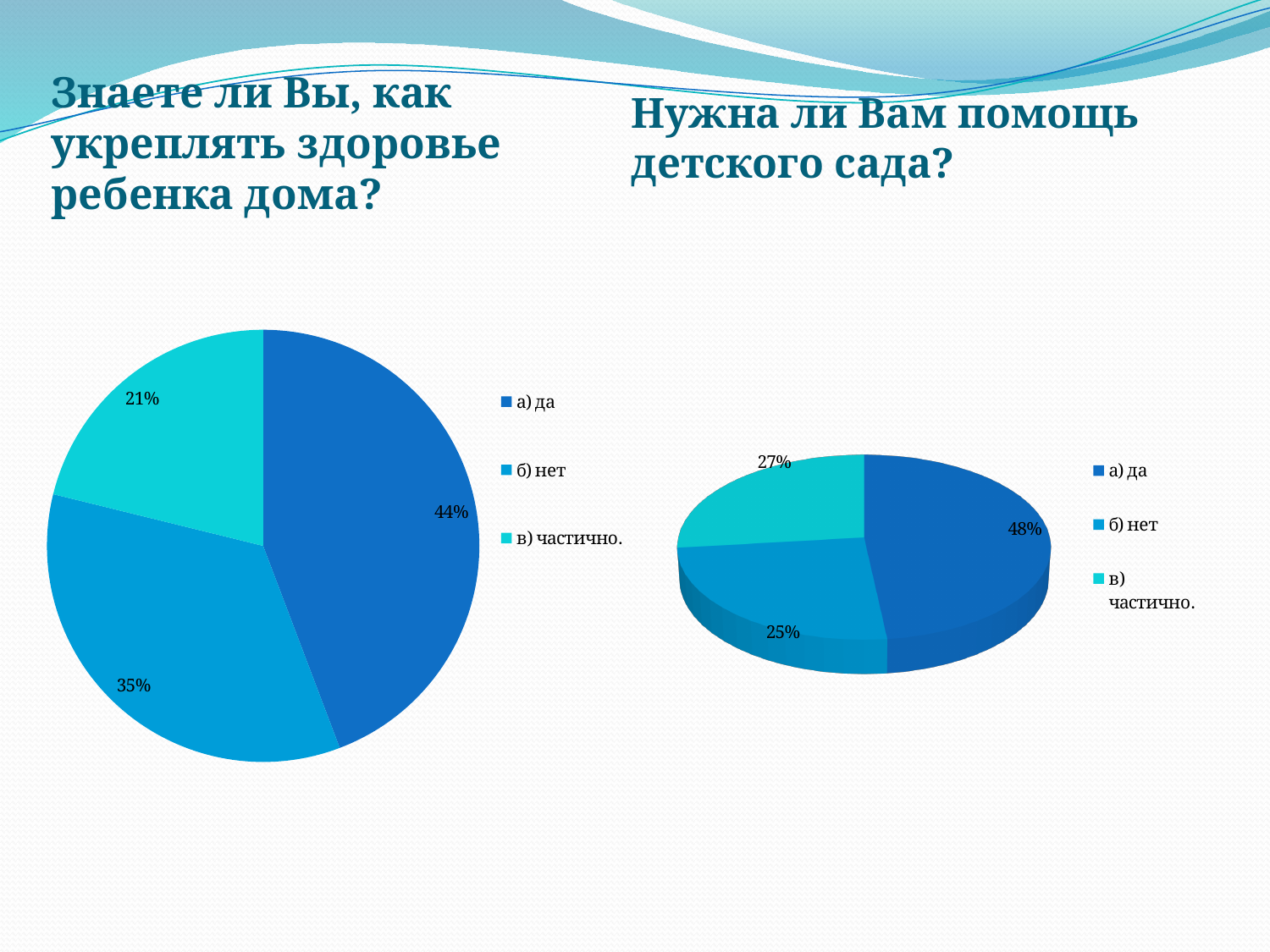
What type of chart is the left chart ("Знаете ли Вы, как укреплять здоровье ребенка дома?")? Pie chart In the left pie chart ("Знаете ли Вы, как укреплять здоровье ребенка дома?"), which category has the smallest slice? в) частично. In the left pie chart ("Знаете ли Вы, как укреплять здоровье ребенка дома?"), what is the difference in percentage points between "а) да" and "б) нет"? 9 In the left pie chart ("Знаете ли Вы, как укреплять здоровье ребенка дома?"), what share is labelled for "в) частично."? 21% In the right pie chart ("Нужна ли Вам помощь детского сада?"), what share is labelled for "в) частично."? 27% In the right pie chart ("Нужна ли Вам помощь детского сада?"), which is larger, "б) нет" or "в) частично."? в) частично. In the right pie chart ("Нужна ли Вам помощь детского сада?"), what share is labelled for "а) да"? 48% In the right pie chart ("Нужна ли Вам помощь детского сада?"), what share is labelled for "б) нет"? 25% How many categories does the legend of the right pie chart ("Нужна ли Вам помощь детского сада?") list? 3 In the left pie chart ("Знаете ли Вы, как укреплять здоровье ребенка дома?"), which category has the largest slice? а) да In the left pie chart ("Знаете ли Вы, как укреплять здоровье ребенка дома?"), what share is labelled for "а) да"? 44% In the left pie chart ("Знаете ли Вы, как укреплять здоровье ребенка дома?"), what share is labelled for "б) нет"? 35%